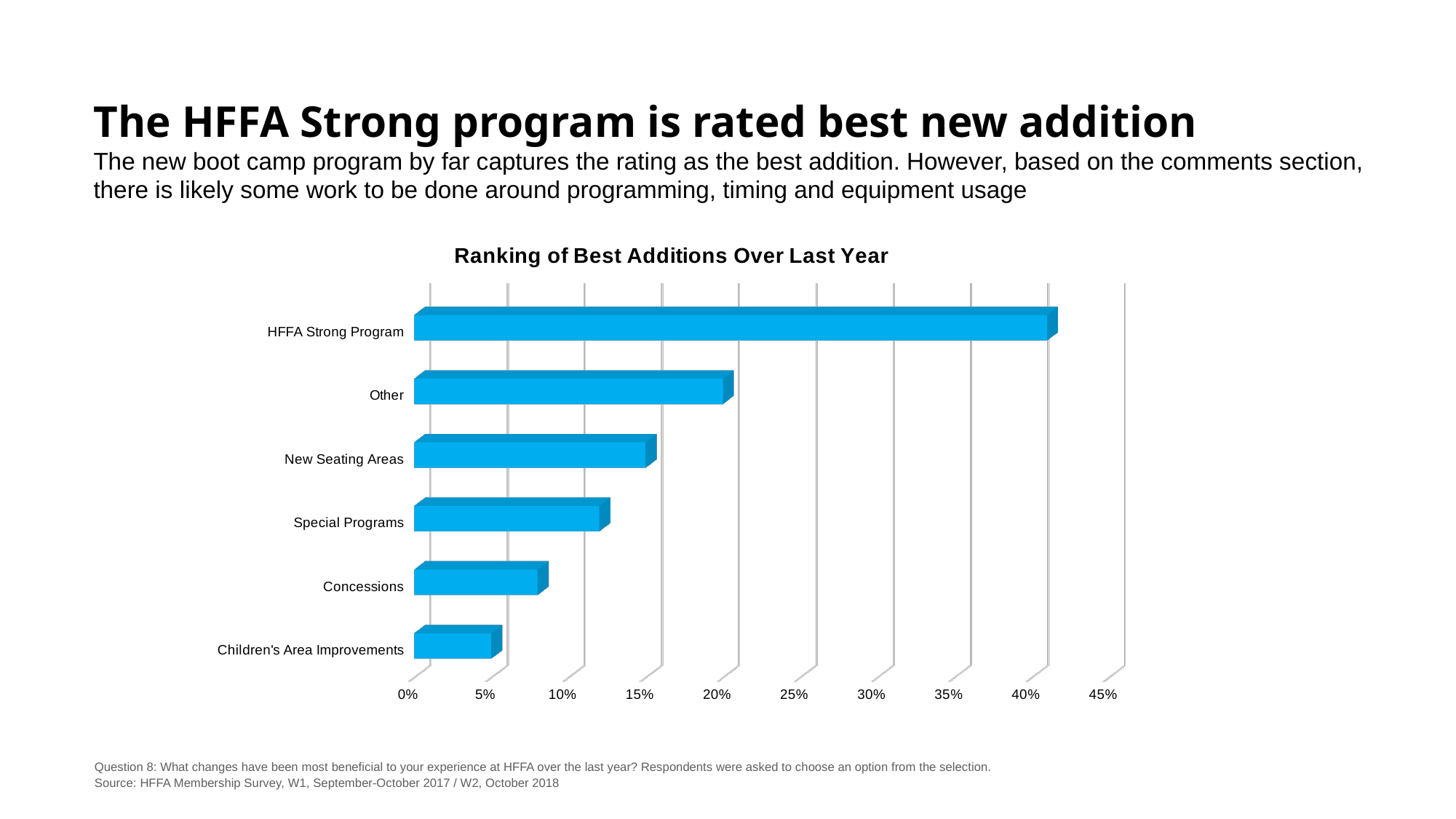
Which category has the highest value? HFFA Strong Program What type of chart is shown on the slide? bar chart How many categories are shown in the chart? 6 Which category has the lowest value? Children's Area Improvements Is the value for Special Programs greater or less than 10%? greater Is the value for Concessions greater or less than 10%? less Which is larger, the value for Other or the value for Special Programs? Other Is the value for HFFA Strong Program greater or less than 35%? greater What is the title of the chart? Ranking of Best Additions Over Last Year What colour are the bars in the chart? blue